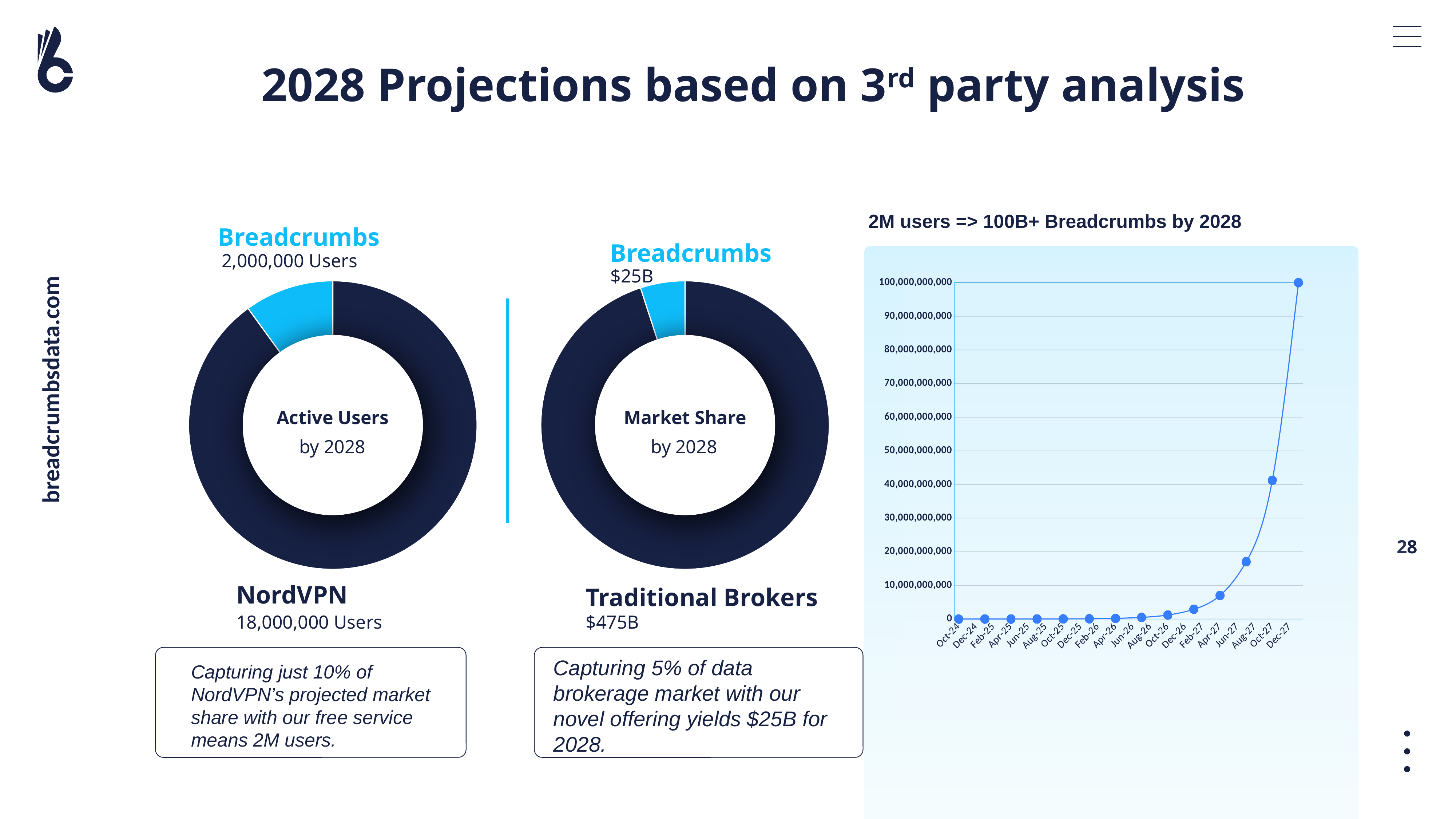
On the Active Users by 2028 donut chart, how many users are projected for NordVPN? 18,000,000 Users On the Active Users by 2028 donut chart, what share of the total do Breadcrumbs users represent? 10% On the Market Share by 2028 donut chart, what share of the total does Breadcrumbs represent? 5% On the Market Share by 2028 donut chart, which segment is larger, Breadcrumbs or Traditional Brokers? Traditional Brokers On the Market Share by 2028 donut chart, what is the difference between Traditional Brokers and Breadcrumbs? $450B On the Active Users by 2028 donut chart, how many users are projected for Breadcrumbs? 2,000,000 Users On the Market Share by 2028 donut chart, what is the value for Breadcrumbs? $25B On the Market Share by 2028 donut chart, what is the value for Traditional Brokers? $475B On the '2M users => 100B+ Breadcrumbs by 2028' line chart, how many data points are plotted? 14 What kind of chart is the '2M users => 100B+ Breadcrumbs by 2028' chart on the right? Line chart On the '2M users => 100B+ Breadcrumbs by 2028' line chart, is the value for Aug-27 greater or less than 10,000,000,000? greater On the Active Users by 2028 donut chart, what is the difference in users between NordVPN and Breadcrumbs? 16,000,000 Users